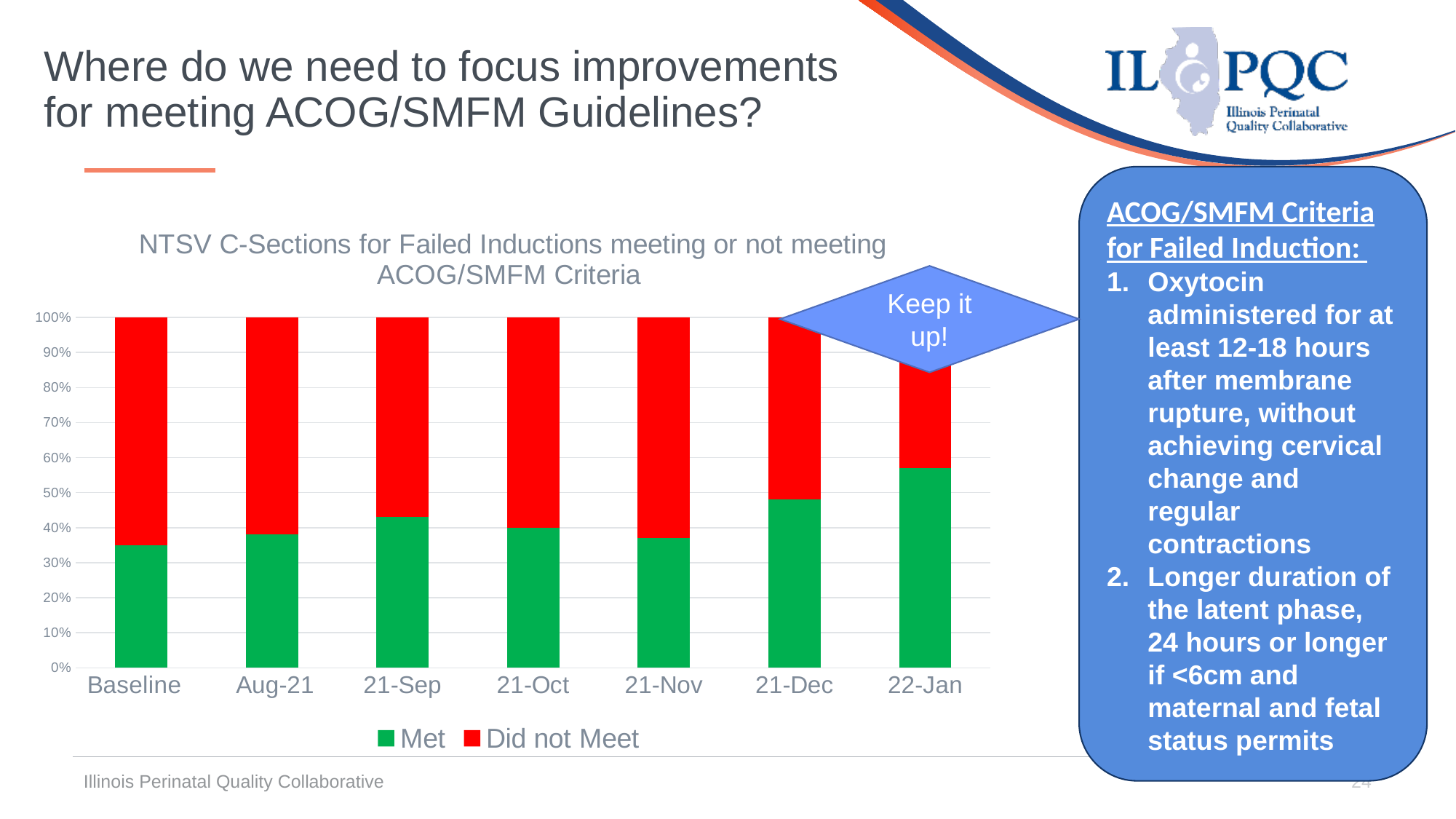
Which category has the highest value for the Met series? 22-Jan Which colour represents the Did not Meet series in the chart? red Is the Met value for 22-Jan greater or less than 50%? greater What kind of chart is shown on the slide? bar chart How many series does the chart's legend list? 2 Is the Met value for 21-Nov greater or less than 40%? less What is the total of the stacked bar for Baseline? 100% Does the Met series rise or fall from 21-Nov to 22-Jan? rise How many categories are shown along the x axis of the chart? 7 Is the Met value for Baseline greater or less than 40%? less Which is larger, the Met value for 21-Dec or the Met value for 21-Oct? 21-Dec